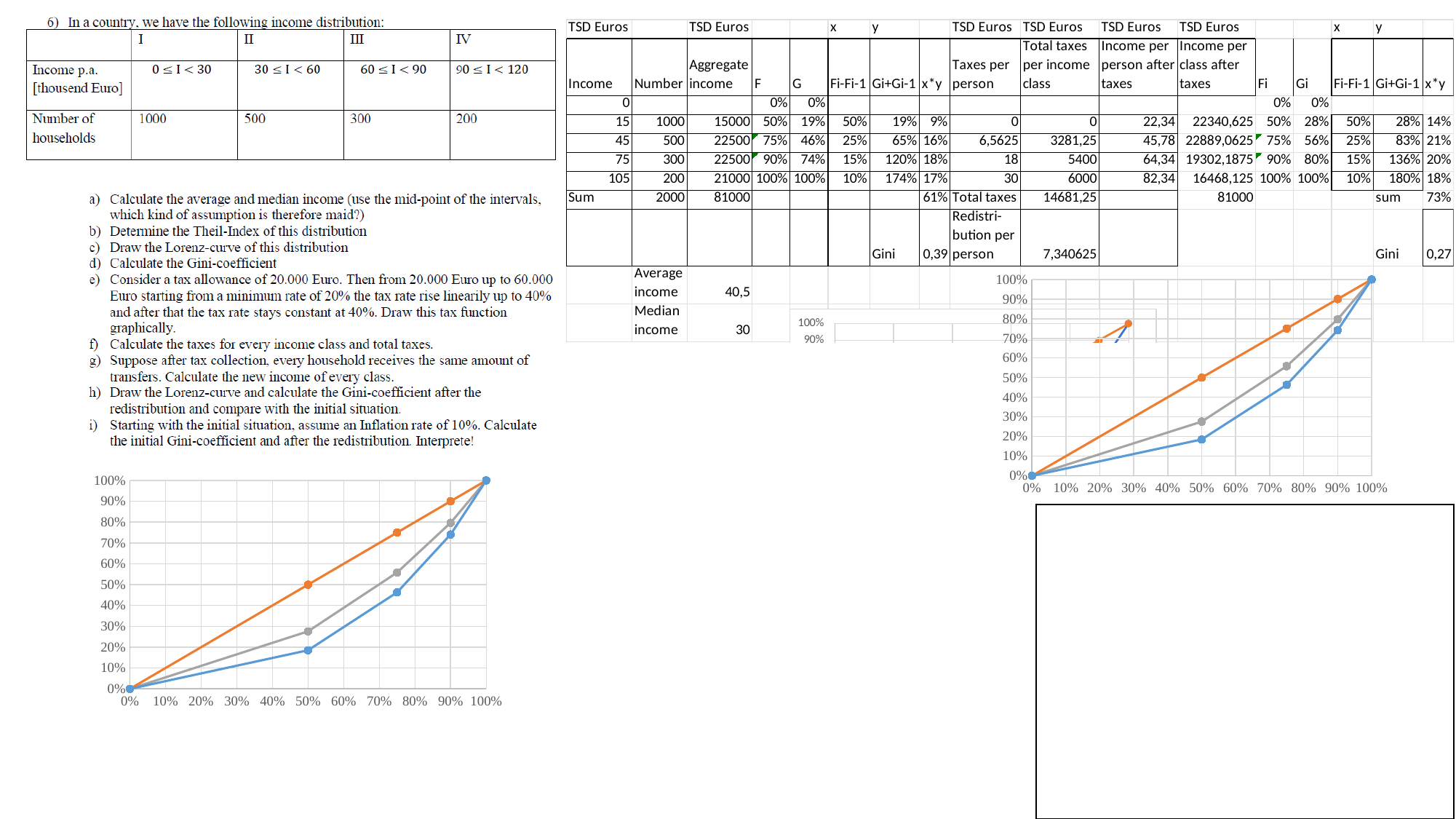
In the right-hand chart, do the lines rise or fall as the x axis increases from 0% to 100%? rise In the bottom-left chart, which line is lowest at 50% on the x axis? the blue line In the bottom-left chart, at 75% on the x axis, is the grey line or the blue line higher? the grey line In the bottom-left chart, how many lines are plotted? 3 In the bottom-left chart, what value do all three lines reach at 100% on the x axis? 100% In the bottom-left chart, which line is highest at 75% on the x axis? the orange line In the bottom-left chart, is the value of the blue line at 75% on the x axis greater or less than 50%? less In the bottom-left chart, is the value of the blue line at 50% on the x axis greater or less than 30%? less In the bottom-left chart, what is the value of the orange line at 50% on the x axis? 50% In the right-hand chart, is the value of the blue line at 90% on the x axis greater or less than 70%? greater What kind of chart is the bottom-left chart on the slide? line chart